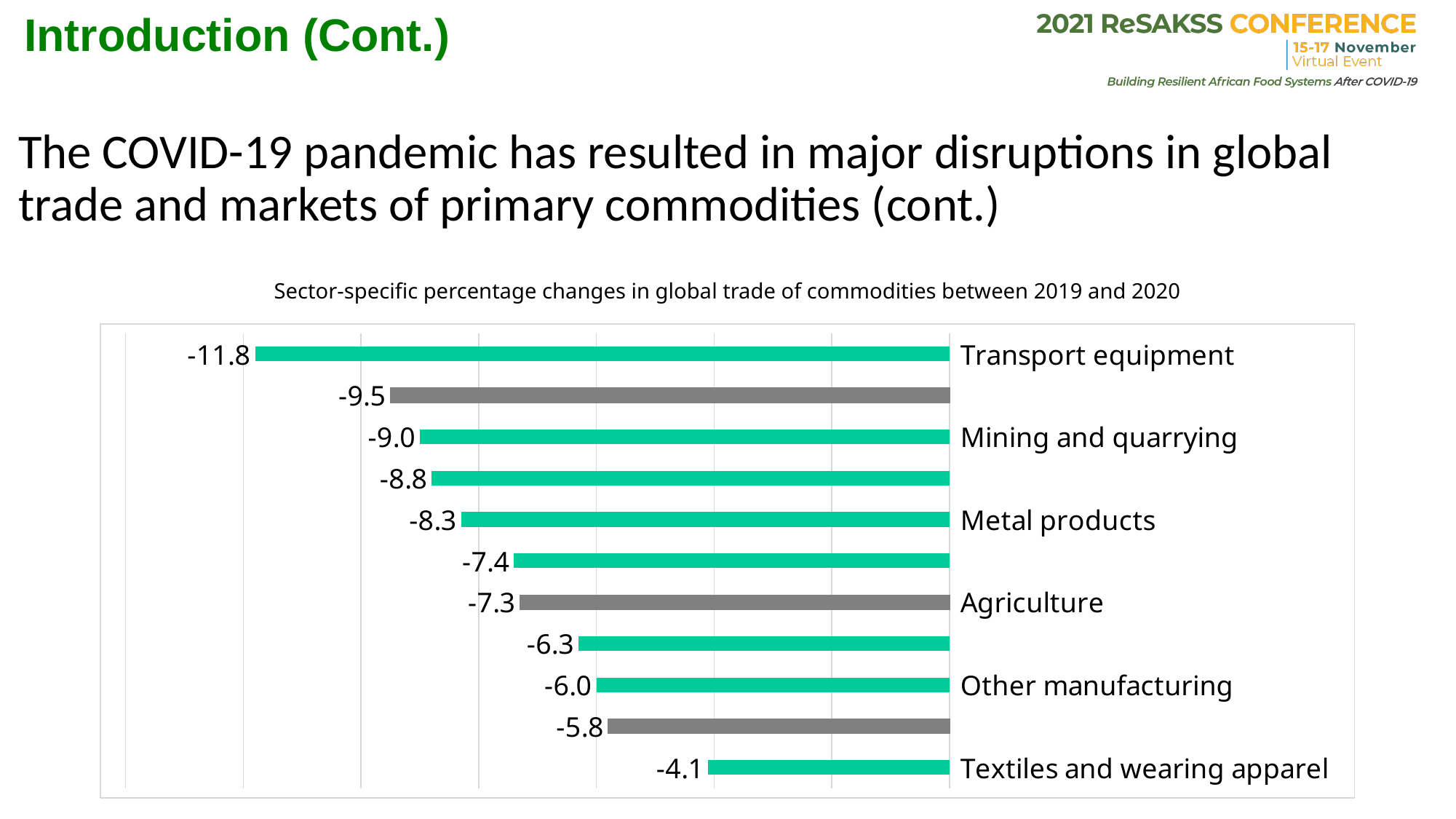
What is the percentage change for Transport equipment? -11.8 Which labelled sector shows the largest decline in global trade? Transport equipment What type of chart is shown on the slide? Bar chart What is the title of the chart? Sector-specific percentage changes in global trade of commodities between 2019 and 2020 What is the difference between the percentage changes for Metal products and Other manufacturing? 2.3 What is the percentage change for Agriculture? -7.3 What is the difference between the percentage changes for Transport equipment and Textiles and wearing apparel? 7.7 What is the percentage change for Textiles and wearing apparel? -4.1 What is the percentage change for Mining and quarrying? -9.0 Which sector had a larger decline, Mining and quarrying or Agriculture? Mining and quarrying How many bars are plotted in the chart? 11 Which labelled sector shows the smallest decline in global trade? Textiles and wearing apparel